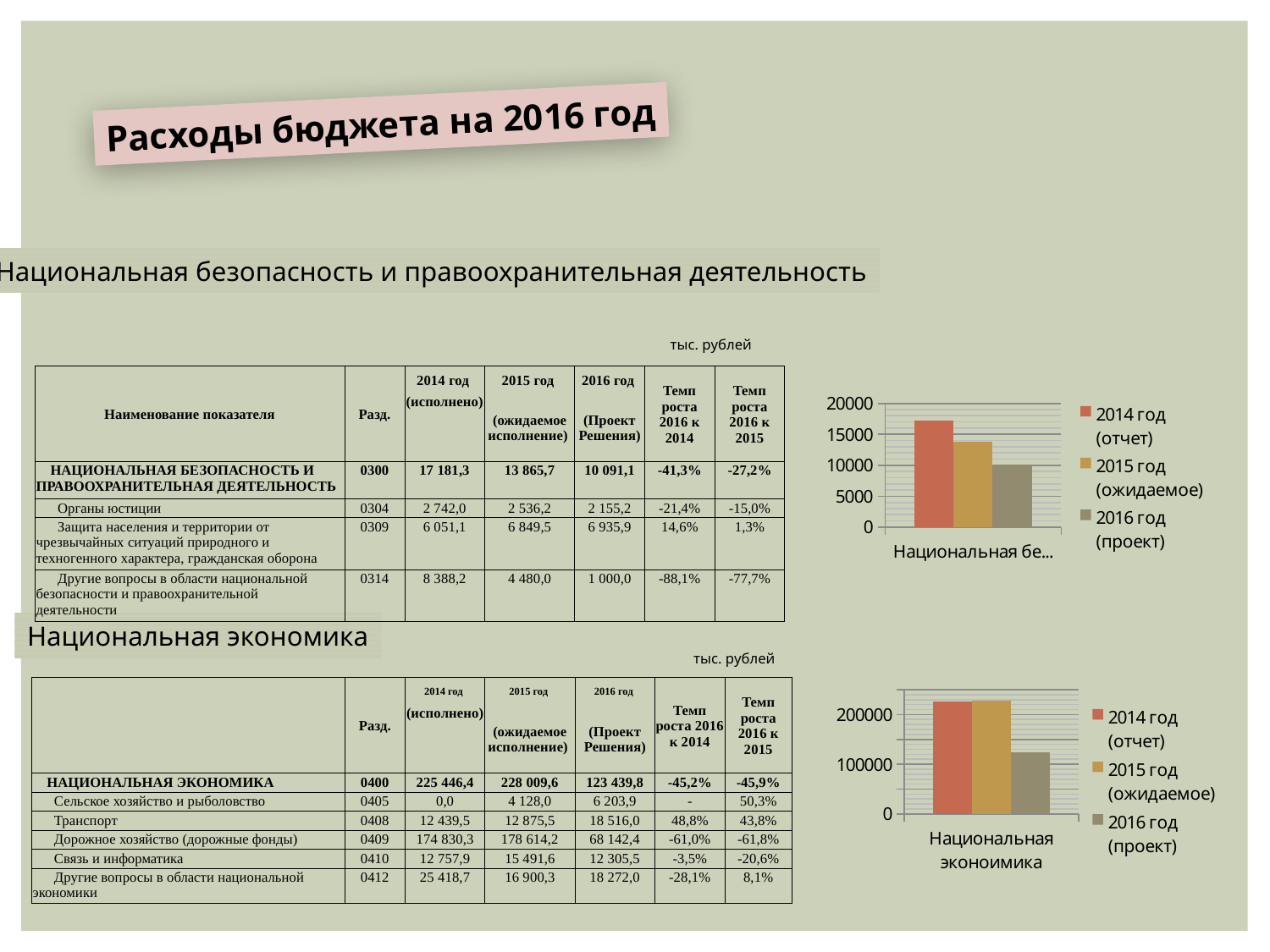
In the bottom chart, what colour is the bar for 2016 год (проект)? grey In the top chart (Национальная безопасность), how many series does the legend list? 3 In the top chart (Национальная безопасность), do the bars rise or fall from 2014 to 2016? fall In the top chart (Национальная безопасность), is the value for 2015 год (ожидаемое) greater or less than 15000? less In the top chart (Национальная безопасность), which series has the tallest bar? 2014 год (отчет) In the top chart (Национальная безопасность), is the value for 2014 год (отчет) greater or less than 15000? greater What kind of chart is shown next to the 'Национальная безопасность и правоохранительная деятельность' table? bar chart In the bottom chart (Национальная экономика), is the value for 2015 год (ожидаемое) greater or less than 200000? greater In the top chart (Национальная безопасность), which series has the shortest bar? 2016 год (проект) In the bottom chart (Национальная экономика), which series has the shortest bar? 2016 год (проект) In the bottom chart (Национальная экономика), which is larger: the bar for 2014 год (отчет) or the bar for 2016 год (проект)? 2014 год (отчет)